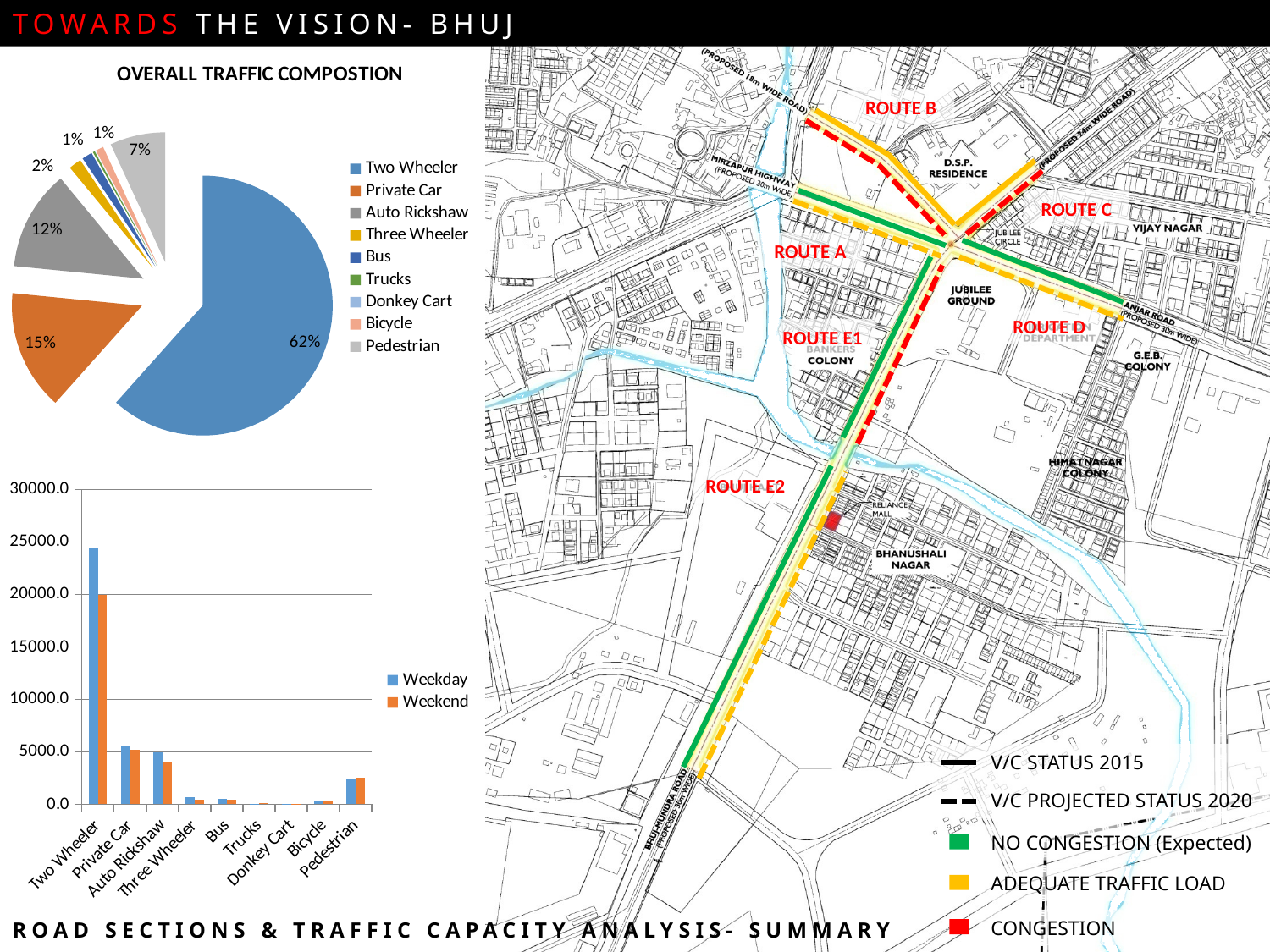
In the OVERALL TRAFFIC COMPOSTION pie chart, what share is shown for Auto Rickshaw? 12% In the OVERALL TRAFFIC COMPOSTION pie chart, what share is shown for Two Wheeler? 62% In the bar chart at the bottom left, which is larger for Two Wheeler, the Weekday value or the Weekend value? Weekday What kind of chart is the chart at the bottom left of the slide? Bar chart In the bar chart at the bottom left, which category has the highest Weekday value? Two Wheeler In the bar chart at the bottom left, is the Weekday value for Two Wheeler greater or less than 20000.0? greater In the OVERALL TRAFFIC COMPOSTION pie chart, how many categories does the legend list? 9 In the OVERALL TRAFFIC COMPOSTION pie chart, what is the difference between the Private Car share and the Auto Rickshaw share? 3% In the bar chart at the bottom left, how many series does the legend list? 2 In the OVERALL TRAFFIC COMPOSTION pie chart, what share is shown for Pedestrian? 7% In the OVERALL TRAFFIC COMPOSTION pie chart, what share is shown for Private Car? 15% In the OVERALL TRAFFIC COMPOSTION pie chart, which category has the largest share? Two Wheeler